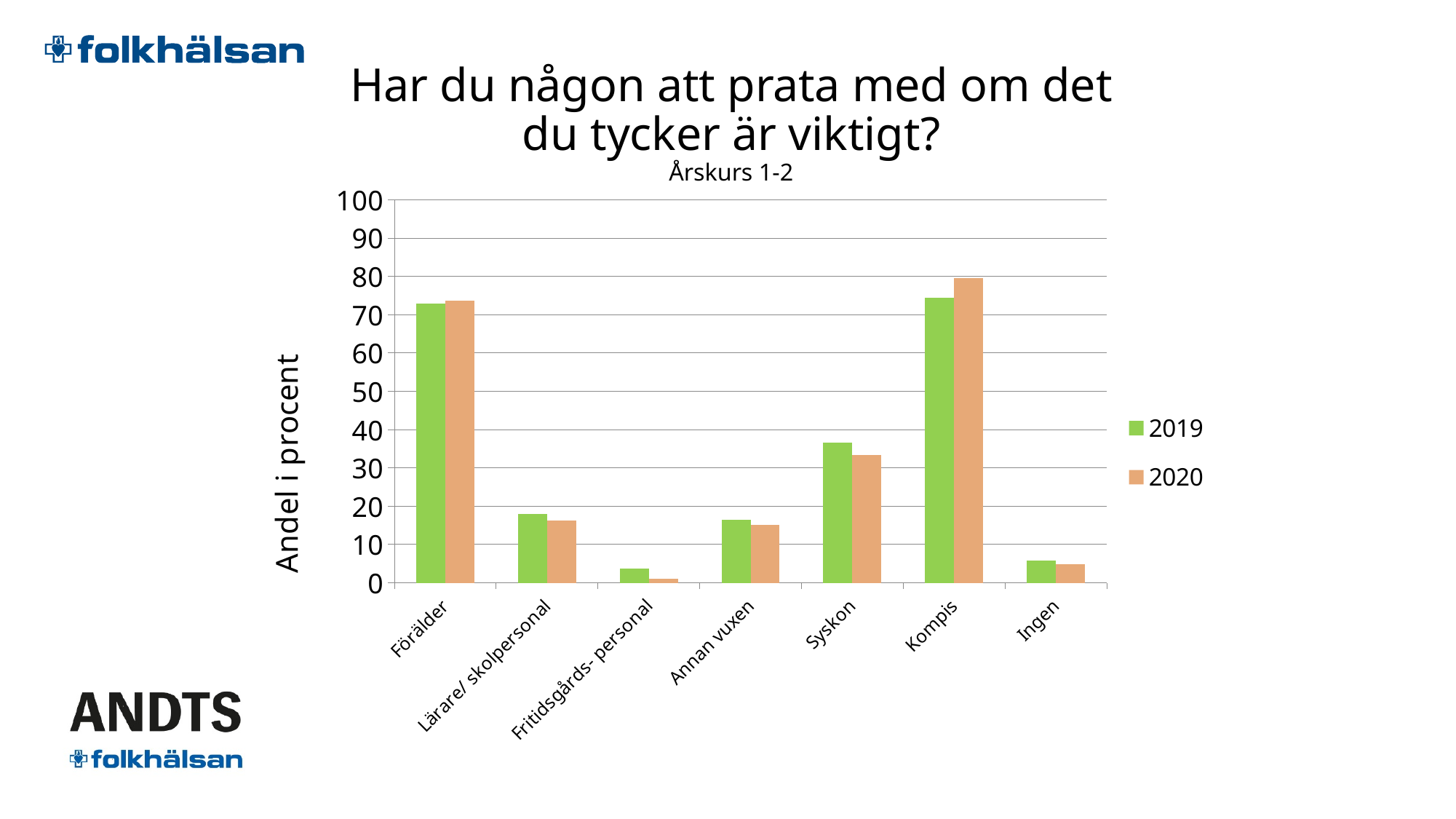
Which category has the lowest value for 2020? Fritidsgårds- personal For Syskon, which year has the larger value, 2019 or 2020? 2019 Is the value for Syskon in 2019 greater or less than 30? greater What kind of chart is shown on the slide? bar chart For Kompis, which year has the larger value, 2019 or 2020? 2020 Is the value for Kompis in 2020 greater or less than 70? greater Which category has the lowest value for 2019? Fritidsgårds- personal Is the value for Ingen in 2019 greater or less than 10? less What is the label of the y axis? Andel i procent Which category has the highest value for 2020? Kompis How many categories are shown on the x axis of the chart? 7 How many series does the legend list? 2